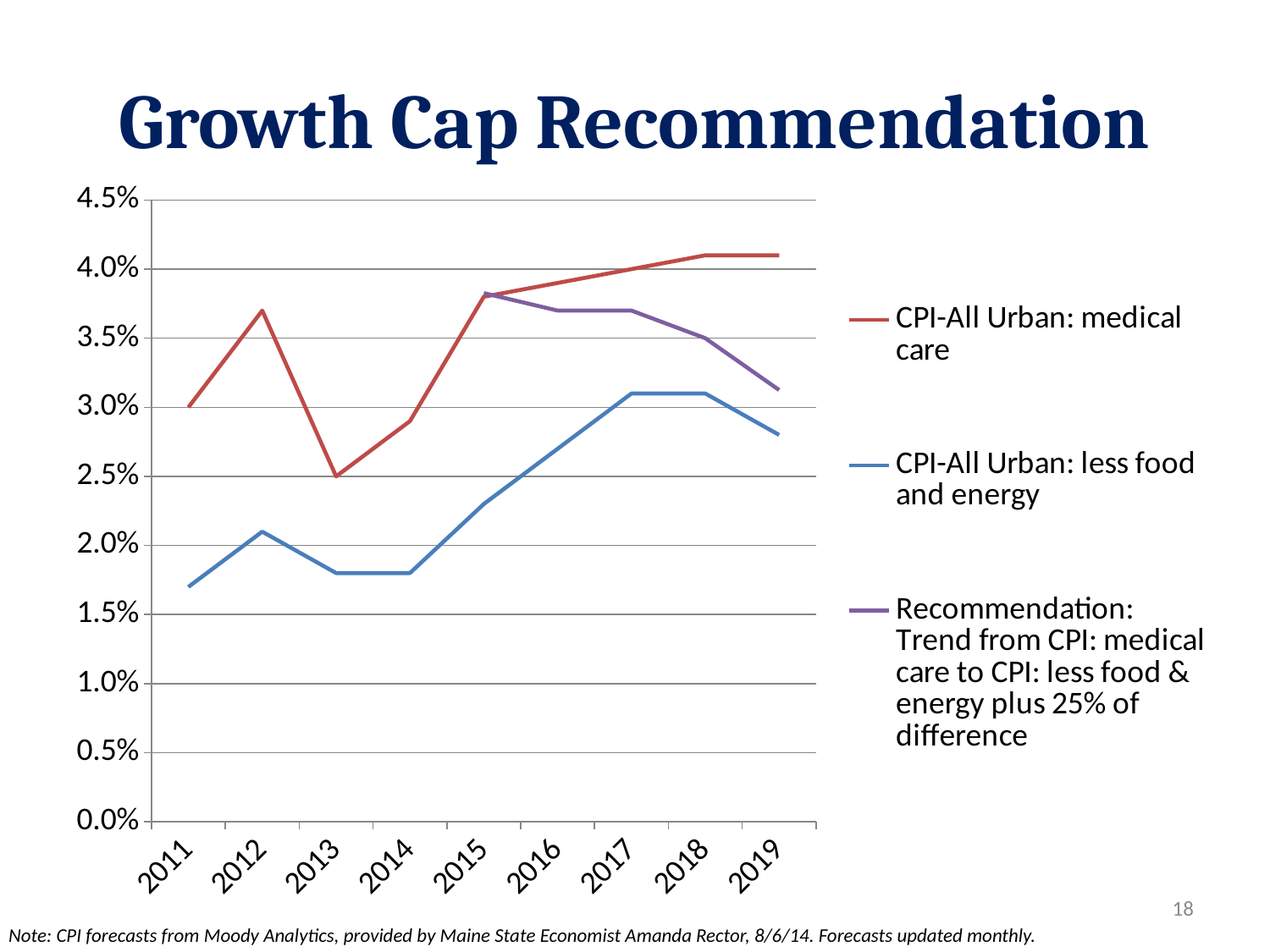
Is the value for CPI-All Urban: medical care in 2012 greater or less than 3.5%? greater How many years are shown along the x axis? 9 What kind of chart is shown on the slide? line chart Is the value for CPI-All Urban: medical care in 2019 greater or less than 4.0%? greater In 2015, which is higher: CPI-All Urban: medical care or CPI-All Urban: less food and energy? CPI-All Urban: medical care Is the value for CPI-All Urban: less food and energy in 2011 greater or less than 2.0%? less Which colour is used for the CPI-All Urban: medical care line? red In which year is the CPI-All Urban: medical care series at its lowest? 2013 How many series does the legend list? 3 What is the title of the slide's chart? Growth Cap Recommendation Does the CPI-All Urban: less food and energy series rise or fall from 2014 to 2017? rise